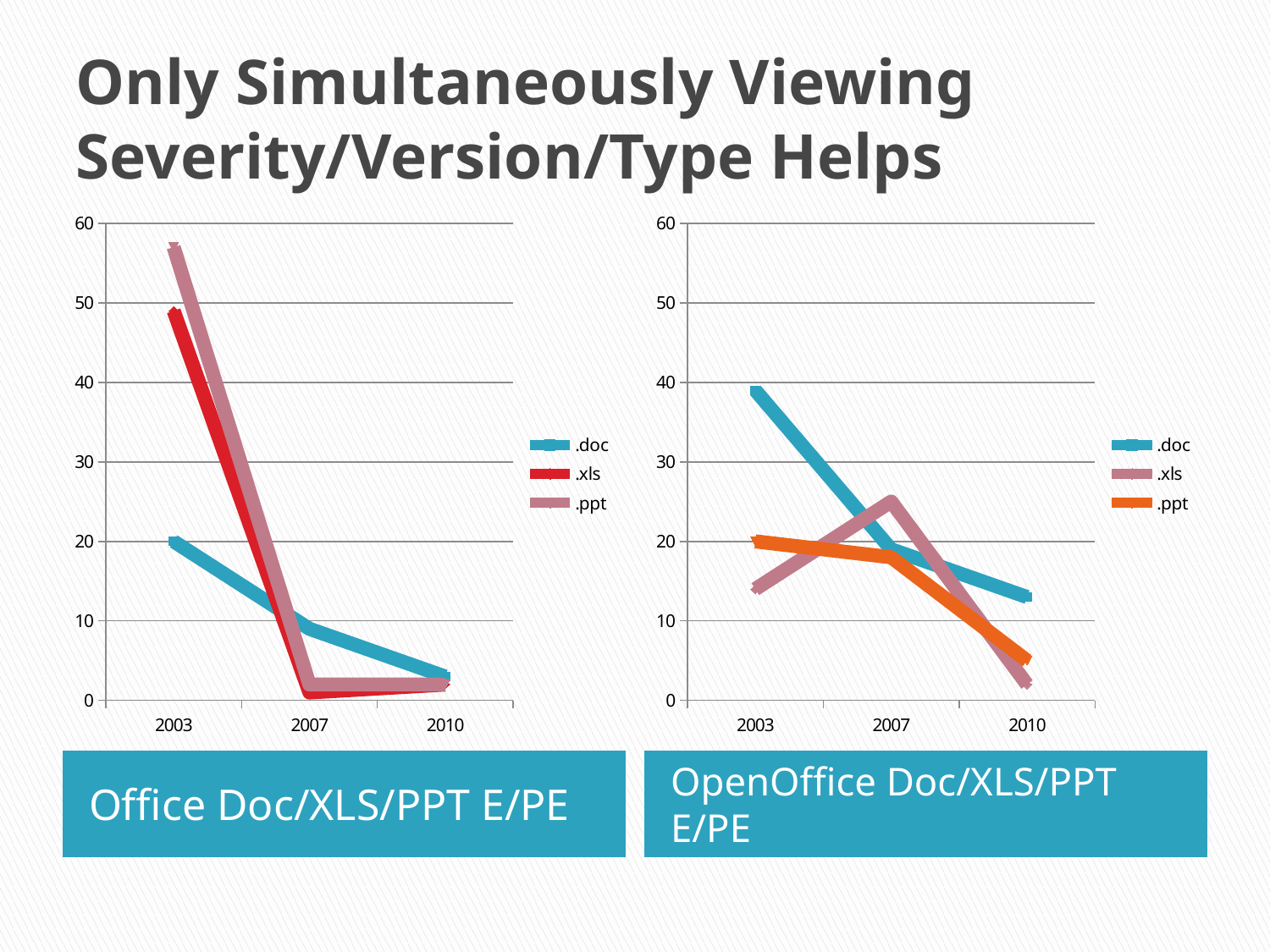
In the right chart, labelled "OpenOffice Doc/XLS/PPT E/PE", is the .xls value for 2010 greater or less than 10? less In the left chart, labelled "Office Doc/XLS/PPT E/PE", does the .doc series rise or fall from 2003 to 2010? fall In the right chart, labelled "OpenOffice Doc/XLS/PPT E/PE", is the .doc value for 2003 greater or less than 30? greater In the left chart, labelled "Office Doc/XLS/PPT E/PE", is the .xls value for 2003 greater or less than 40? greater How many series does the legend of the right chart, labelled "OpenOffice Doc/XLS/PPT E/PE", list? 3 What kind of chart is the left chart, labelled "Office Doc/XLS/PPT E/PE"? line chart In the right chart, labelled "OpenOffice Doc/XLS/PPT E/PE", which is larger in 2010: the .doc value or the .xls value? .doc How many years are shown on the x axis of the left chart, labelled "Office Doc/XLS/PPT E/PE"? 3 What are the three legend entries of the left chart, labelled "Office Doc/XLS/PPT E/PE"? .doc, .xls, .ppt In the right chart, labelled "OpenOffice Doc/XLS/PPT E/PE", which series has the highest value in 2007? .xls In the right chart, labelled "OpenOffice Doc/XLS/PPT E/PE", which series has the highest value in 2003? .doc In the left chart, labelled "Office Doc/XLS/PPT E/PE", which series has the highest value in 2003? .ppt